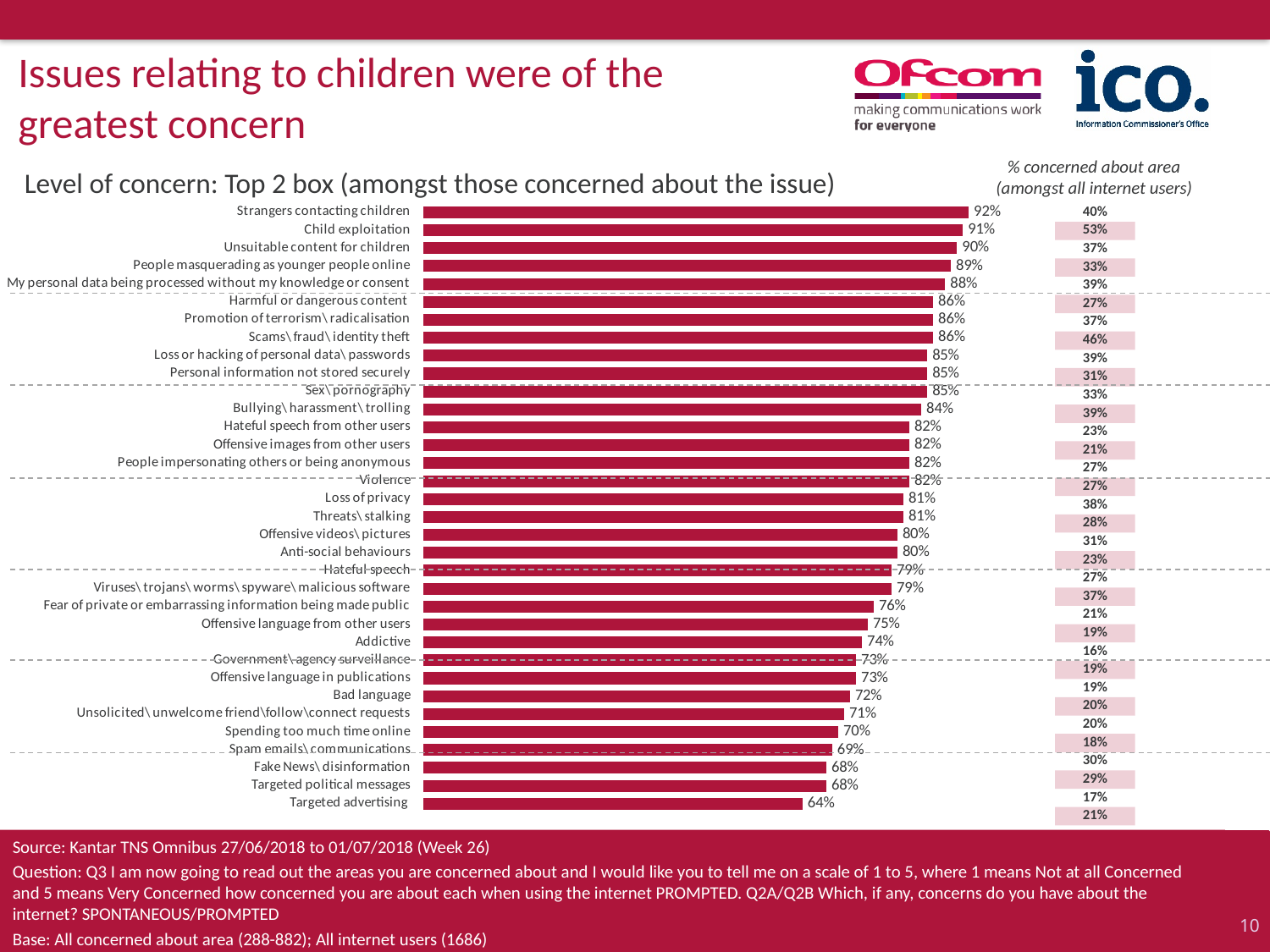
What is the level of concern (Top 2 box) for Fake News\disinformation? 68% How many issues are listed in the bar chart? 34 Which issue has the highest level of concern in the bar chart? Strangers contacting children What is the level of concern (Top 2 box) for Scams\fraud\identity theft? 86% Which has a higher level of concern: Bullying\harassment\trolling or Addictive? Bullying\harassment\trolling What type of chart is used to show the level of concern? Bar chart What is the level of concern (Top 2 box) for Spending too much time online? 70% Do the bar values rise or fall going from the top of the chart to the bottom? Fall What is the difference in level of concern between Child exploitation and Targeted advertising? 27 percentage points Which issue has the lowest level of concern in the bar chart? Targeted advertising What is the level of concern (Top 2 box) for Strangers contacting children? 92% What is the title of the bar chart? Level of concern: Top 2 box (amongst those concerned about the issue)